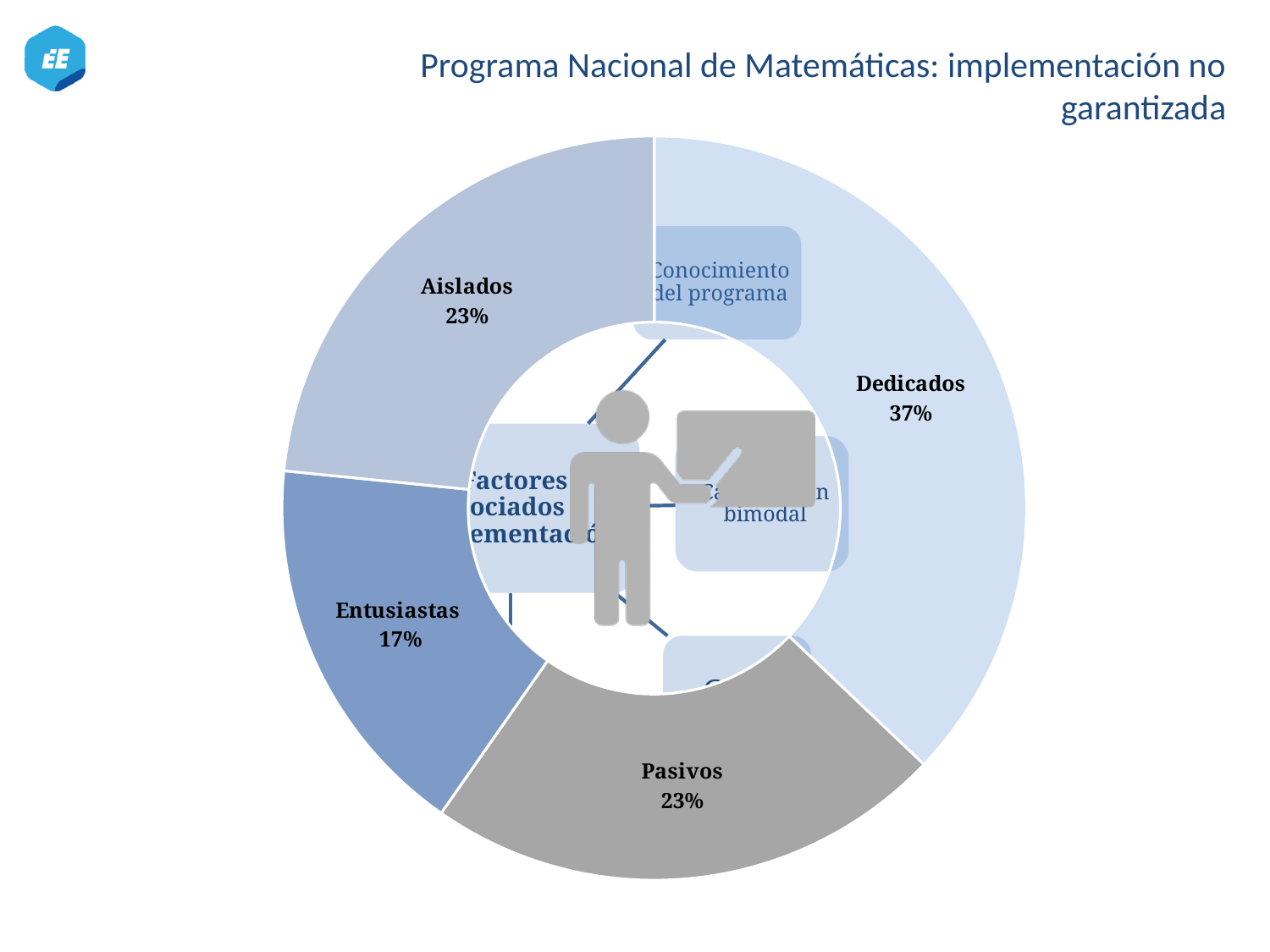
What is the difference in percentage points between Dedicados and Entusiastas? 20 percentage points What percentage is shown for Entusiastas? 17% What percentage is shown for Aislados? 23% Which is larger, the share for Dedicados or the share for Pasivos? Dedicados What share of the chart does the Dedicados segment represent? 37% Which segment of the chart is coloured grey? Pasivos Which segment has the largest share? Dedicados How many segments does the chart have? 4 What kind of chart is shown on the slide? Doughnut (pie) chart Which segment has the smallest share? Entusiastas What is the combined share of Aislados and Pasivos? 46% What percentage is shown for Pasivos? 23%